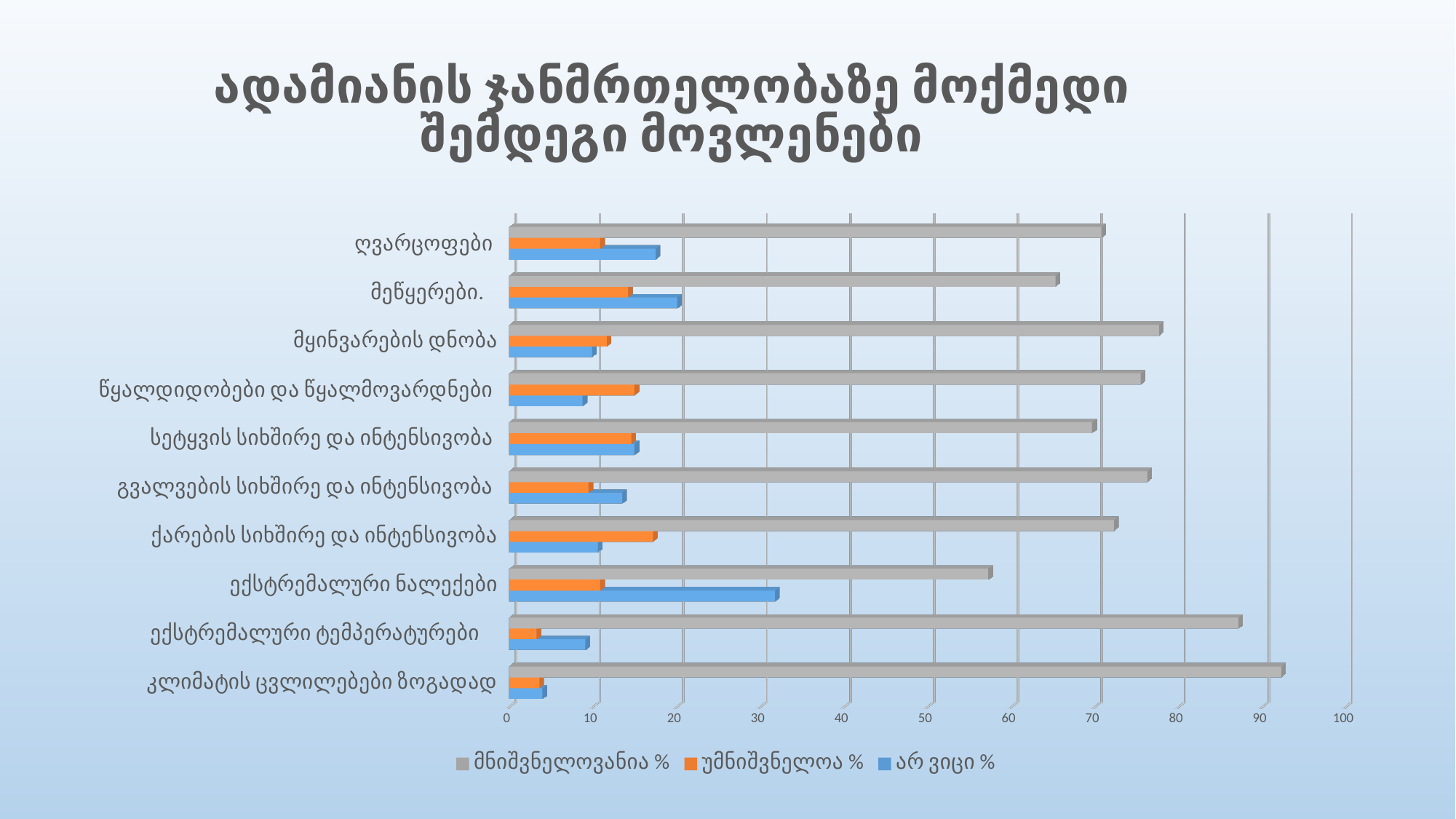
For the მნიშვნელოვანია % series, which is larger: ექსტრემალური ტემპერატურები or მეწყერები? ექსტრემალური ტემპერატურები Which category has the highest value for the არ ვიცი % series? ექსტრემალური ნალექები How many categories are plotted on the chart? 10 Is the არ ვიცი % value for ექსტრემალური ნალექები greater or less than 20? greater Which category has the lowest value for the მნიშვნელოვანია % series? ექსტრემალური ნალექები Is the მნიშვნელოვანია % value for კლიმატის ცვლილებები ზოგადად greater or less than 80? greater Is the უმნიშვნელოა % value for ექსტრემალური ტემპერატურები greater or less than 10? less What kind of chart is shown on the slide? bar chart How many series does the legend list? 3 Which category has the highest value for the მნიშვნელოვანია % series? კლიმატის ცვლილებები ზოგადად Which colour represents the არ ვიცი % series in the legend? blue